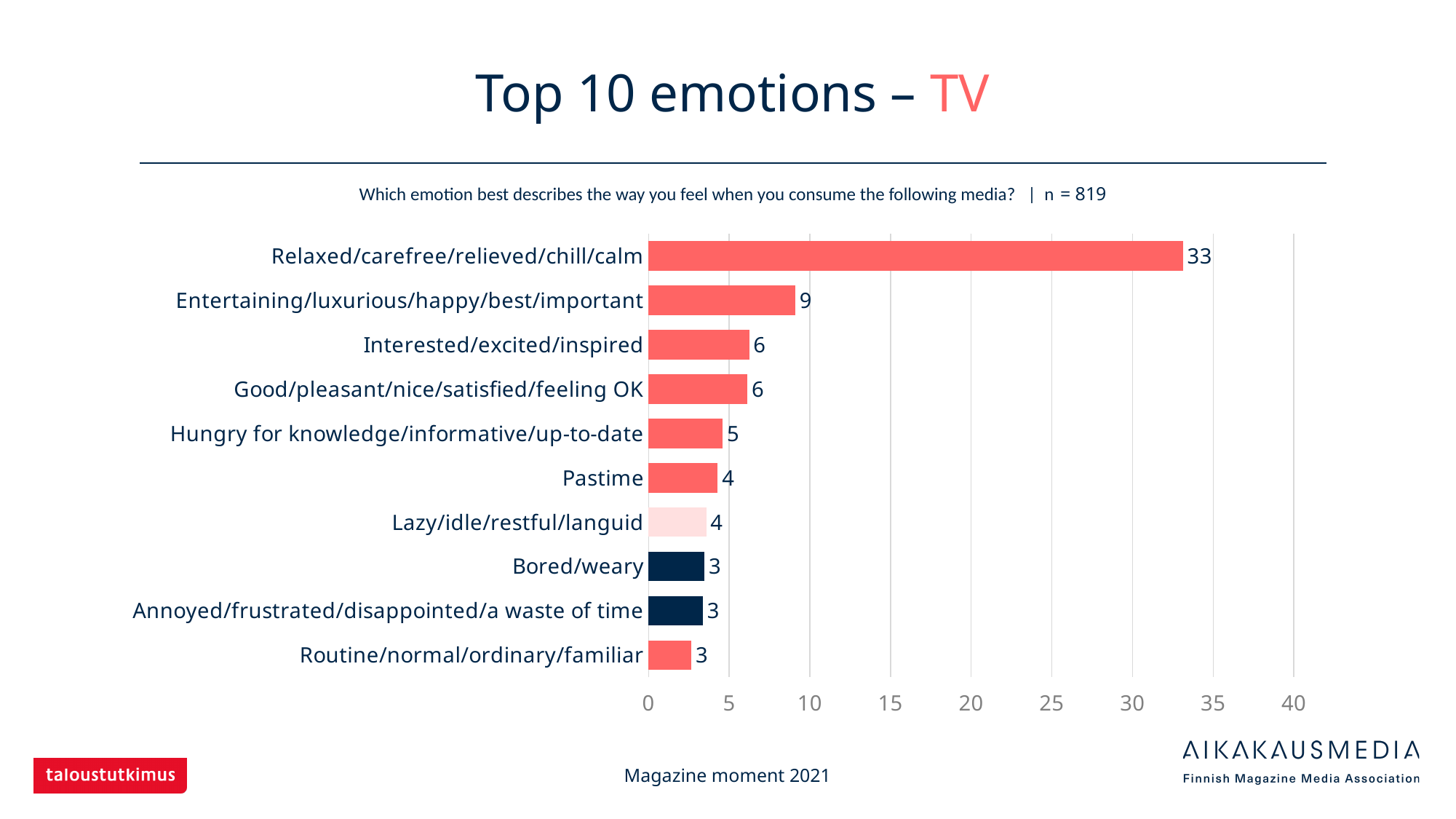
What is the value for Relaxed/carefree/relieved/chill/calm? 33 What is the value for Hungry for knowledge/informative/up-to-date? 5 What is the value for Entertaining/luxurious/happy/best/important? 9 Which emotion has the highest value? Relaxed/carefree/relieved/chill/calm How many emotion categories are shown in the chart? 10 What is the title of the slide? Top 10 emotions – TV Which is larger, the value for Interested/excited/inspired or the value for Pastime? Interested/excited/inspired Is the value for Relaxed/carefree/relieved/chill/calm greater or less than 30? greater What is the difference between the values for Relaxed/carefree/relieved/chill/calm and Entertaining/luxurious/happy/best/important? 24 What is the sample size (n) stated on the slide? 819 What is the value for Lazy/idle/restful/languid? 4 What kind of chart is shown on the slide? bar chart